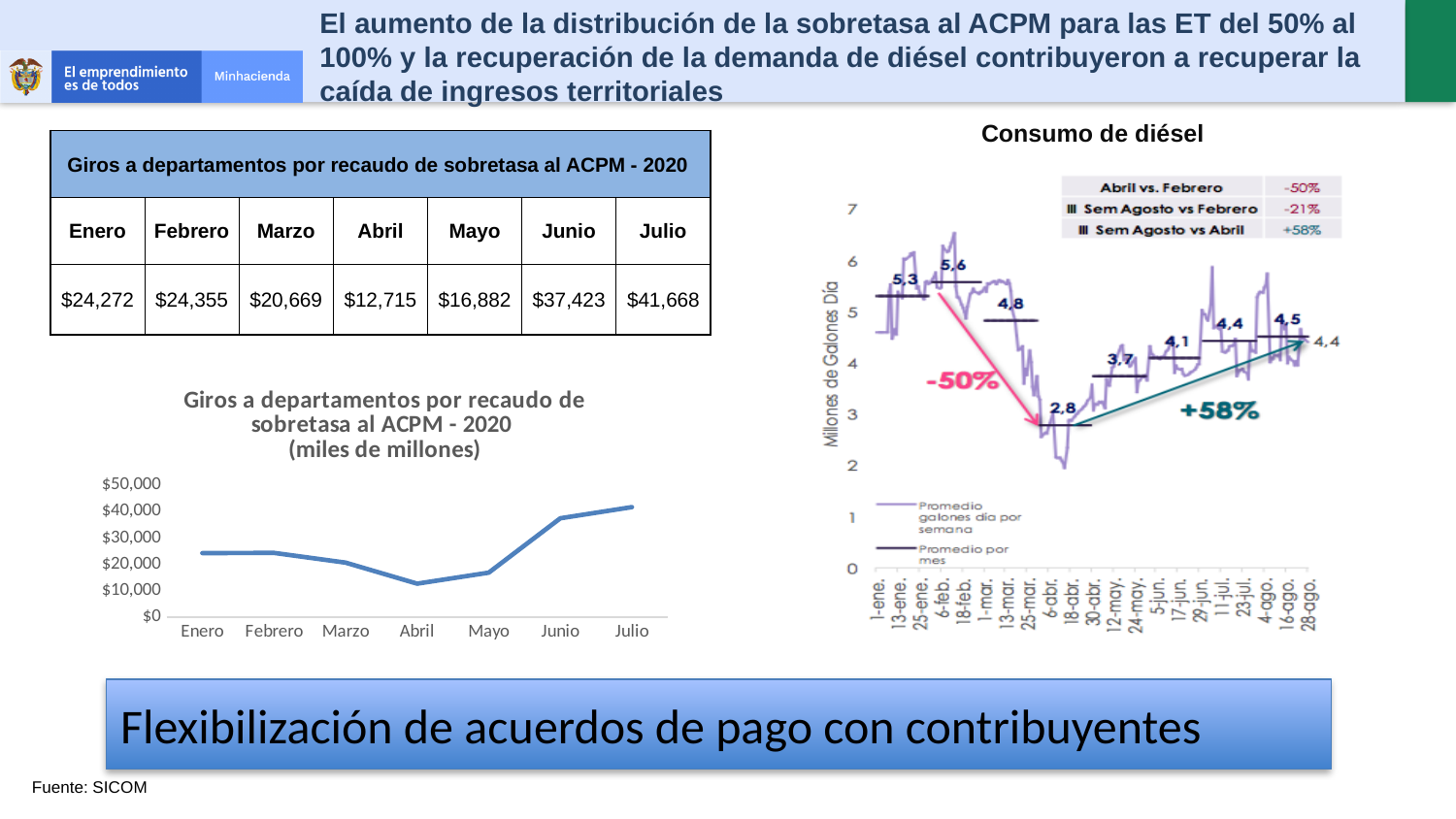
In the 'Consumo de diésel' chart, what percentage change is shown for Abril vs. Febrero? -50% In the 'Giros a departamentos por recaudo de sobretasa al ACPM - 2020' chart, is the value for Abril greater or less than $20,000? less What kind of chart is the 'Giros a departamentos por recaudo de sobretasa al ACPM - 2020' chart? Line chart In the 'Consumo de diésel' chart, what is the lowest monthly average value labelled? 2,8 In the 'Giros a departamentos por recaudo de sobretasa al ACPM - 2020' chart, which month has the lowest value? Abril In the 'Consumo de diésel' chart, how many series does the legend list? 2 According to the slide, what is the difference between the giros for Julio and Abril 2020? $28,953 In the 'Giros a departamentos por recaudo de sobretasa al ACPM - 2020' chart, is the value for Julio greater or less than $40,000? greater In the 'Giros a departamentos por recaudo de sobretasa al ACPM - 2020' chart, do the values rise or fall from Abril to Julio? Rise According to the slide, what is the value of giros a departamentos por recaudo de sobretasa al ACPM for Junio 2020? $37,423 In the 'Giros a departamentos por recaudo de sobretasa al ACPM - 2020' chart, which month has the highest value? Julio In the 'Giros a departamentos por recaudo de sobretasa al ACPM - 2020' chart, how many months are plotted on the x axis? 7